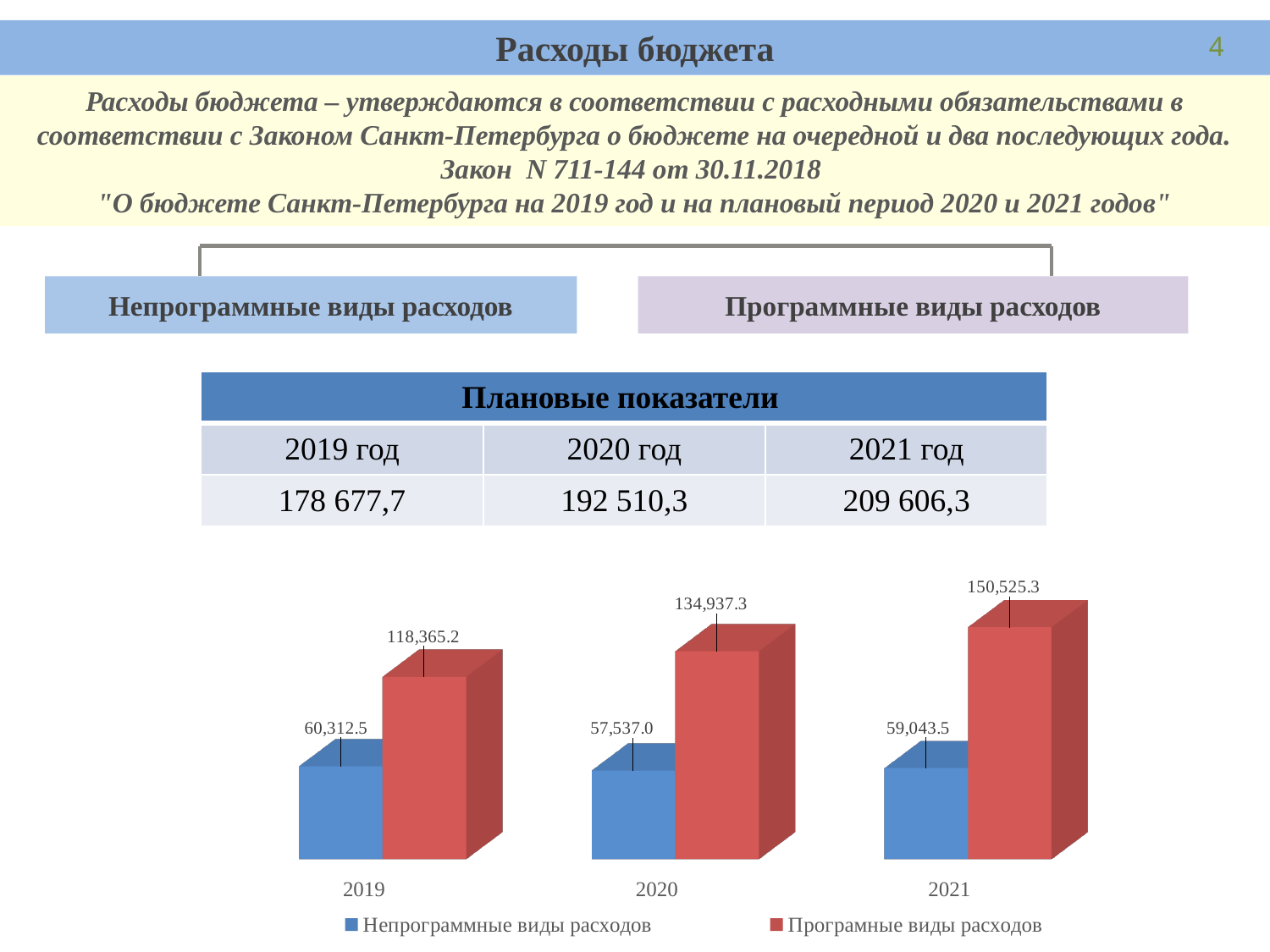
What kind of chart is shown on the slide? Bar chart What is the difference between Програмные виды расходов and Непрограммные виды расходов in 2019? 58,052.7 In which year is Програмные виды расходов highest? 2021 Which is larger in 2020: Непрограммные виды расходов or Програмные виды расходов? Програмные виды расходов What is the value for Програмные виды расходов in 2021? 150,525.3 What is the value for Непрограммные виды расходов in 2021? 59,043.5 How many series does the chart legend list? 2 How many years are shown on the x axis of the chart? 3 What is the value for Програмные виды расходов in 2020? 134,937.3 By how much did Програмные виды расходов increase from 2019 to 2021? 32,160.1 In which year is Непрограммные виды расходов lowest? 2020 What is the value for Непрограммные виды расходов in 2019? 60,312.5